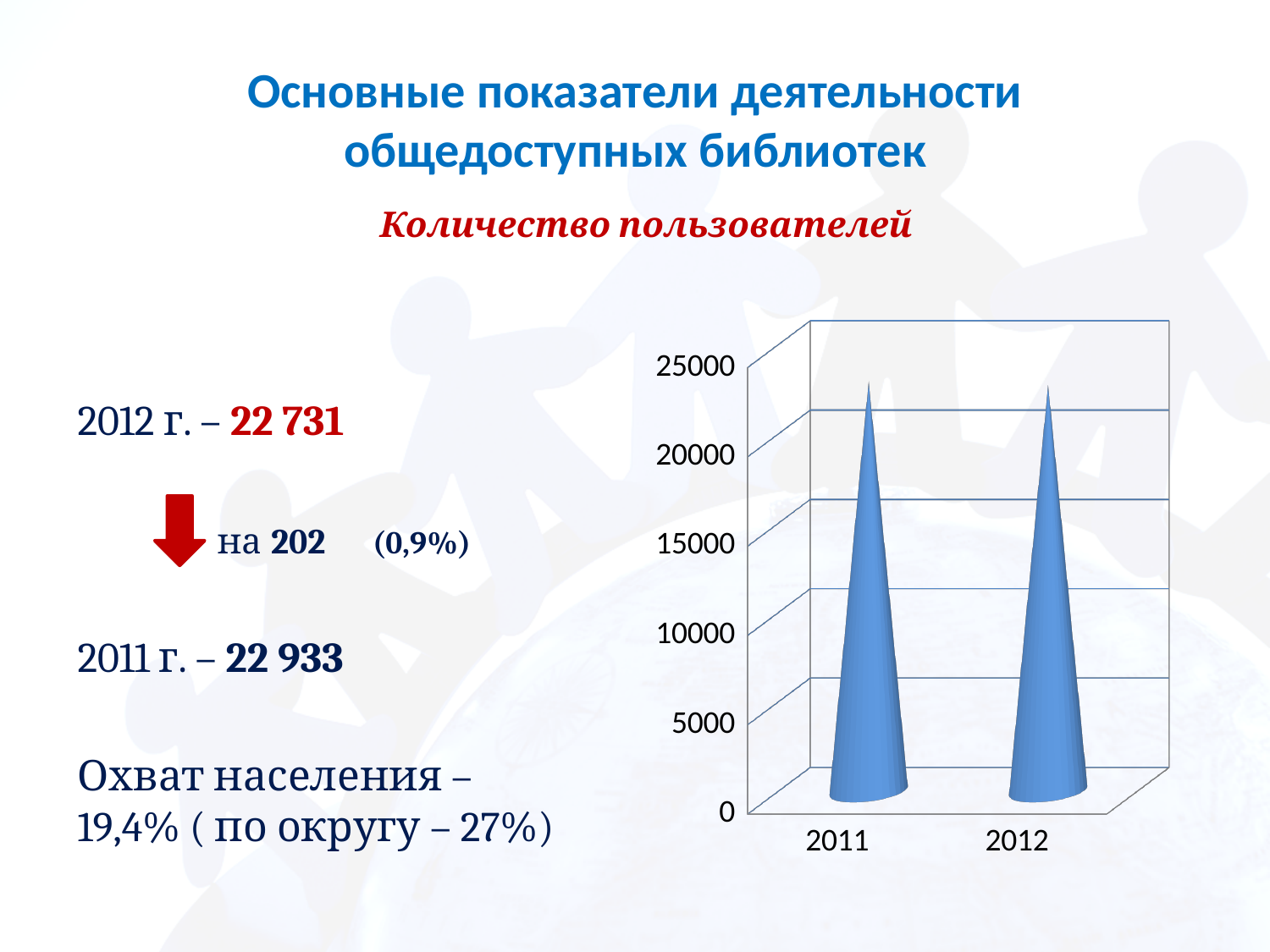
How many categories are shown on the x axis of the chart? 2 What is the highest value shown on the vertical axis of the chart? 25000 What kind of chart is shown on the slide? bar chart Which year has the higher number of users, 2011 or 2012? 2011 Do the values rise or fall from 2011 to 2012? fall Is the value for 2011 greater or less than 20000? greater What is the title of the chart? Количество пользователей Which year has the lowest number of users? 2012 What is the number of users for 2012? 22 731 Is the value for 2012 greater or less than 25000? less What is the number of users for 2011? 22 933 By how much did the number of users change from 2011 to 2012? 202